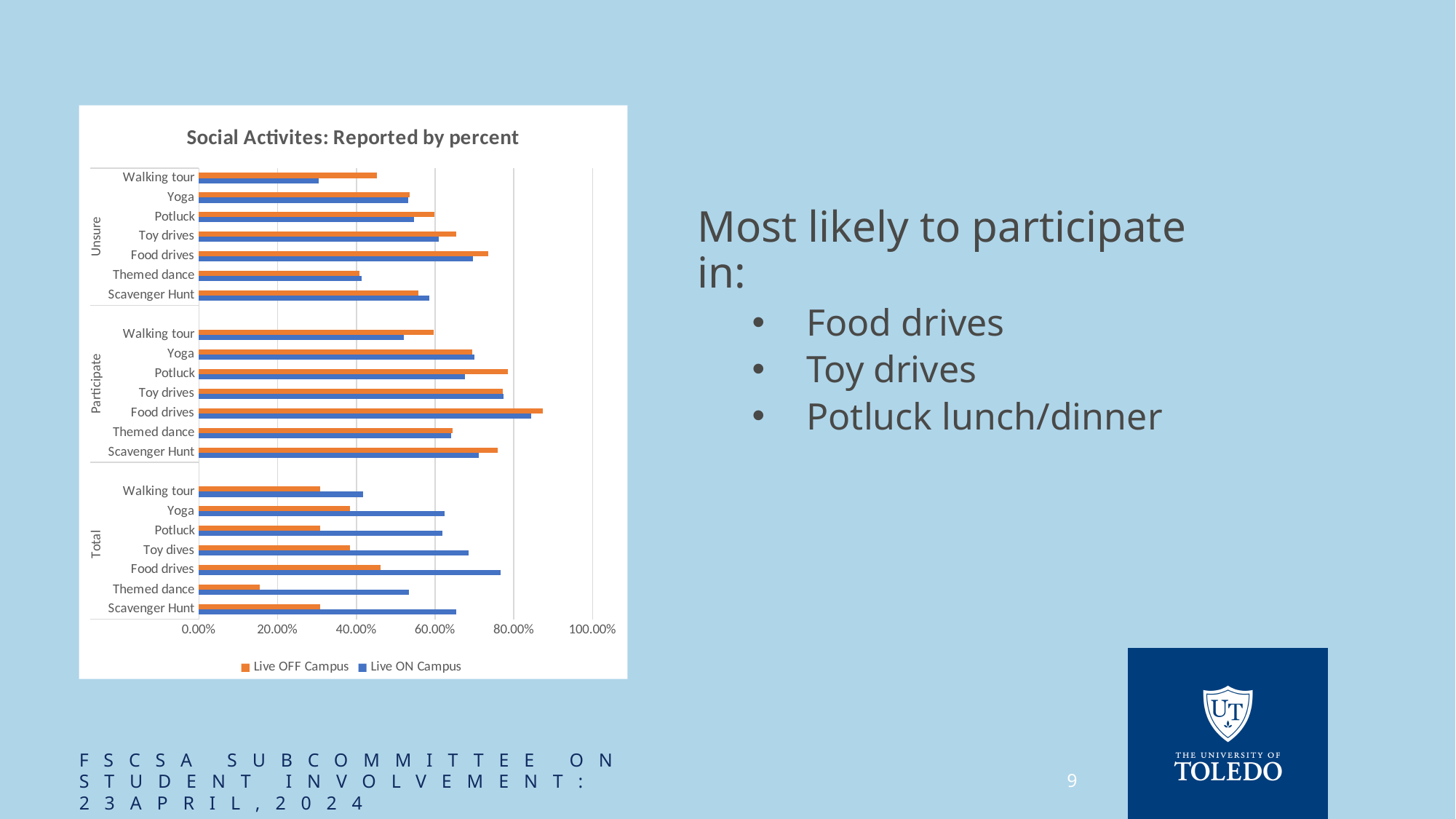
In the Participate group, which activity has the highest Live OFF Campus value? Food drives How many series does the legend of the chart list? 2 What kind of chart is shown on the slide? Bar chart What is the title of the chart? Social Activites: Reported by percent In the Total group, which activity has the lowest Live OFF Campus value? Themed dance In the Participate group, is the Live OFF Campus value for Food drives greater or less than 80.00%? greater In the Unsure group, is the Live ON Campus value for Walking tour greater or less than 40.00%? less How many response groups (Unsure, Participate, Total) are shown on the vertical axis of the chart? 3 In the Total group, is the Live OFF Campus value for Themed dance greater or less than 20.00%? less In the Total group, which series has the larger value for Food drives, Live OFF Campus or Live ON Campus? Live ON Campus What are the two series named in the chart legend? Live OFF Campus and Live ON Campus How many activities are listed within the Total group of the chart? 7